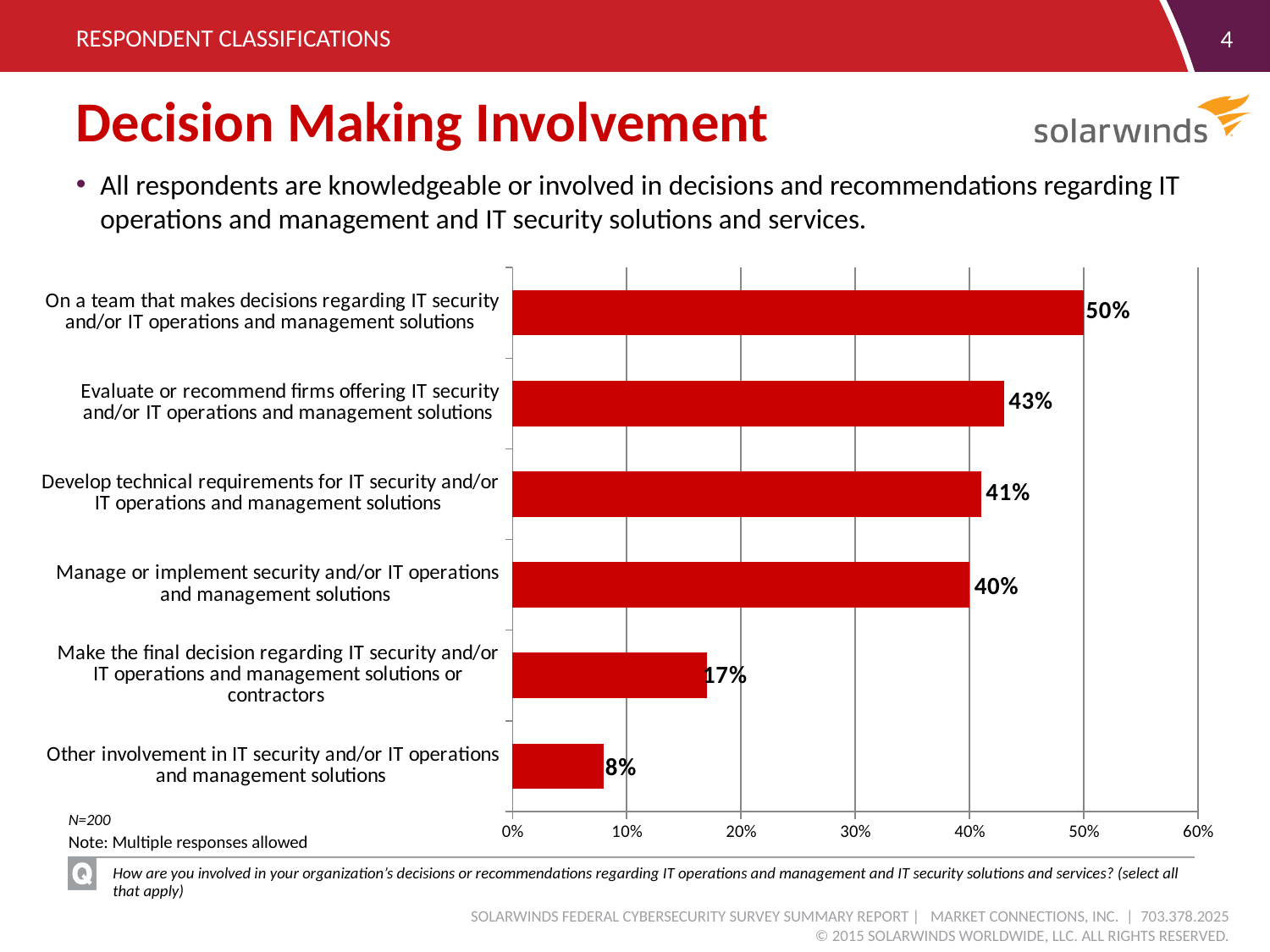
Is the value for 'Manage or implement security and/or IT operations and management solutions' greater or less than 30%? greater Which is larger: the percentage for 'Evaluate or recommend firms' or for 'Make the final decision'? Evaluate or recommend firms What is the sample size (N) noted on the chart? N=200 Which category has the lowest percentage of respondents? Other involvement in IT security and/or IT operations and management solutions Which category has the highest percentage of respondents? On a team that makes decisions regarding IT security and/or IT operations and management solutions What percentage of respondents evaluate or recommend firms offering IT security and/or IT operations and management solutions? 43% What is the difference in percentage points between the highest category and 'Other involvement in IT security and/or IT operations and management solutions'? 42 What type of chart is shown on the slide? Bar chart What percentage of respondents make the final decision regarding IT security and/or IT operations and management solutions or contractors? 17% What is the difference in percentage points between 'Develop technical requirements' and 'Manage or implement' categories? 1 How many categories are shown in the chart? 6 What percentage of respondents are on a team that makes decisions regarding IT security and/or IT operations and management solutions? 50%